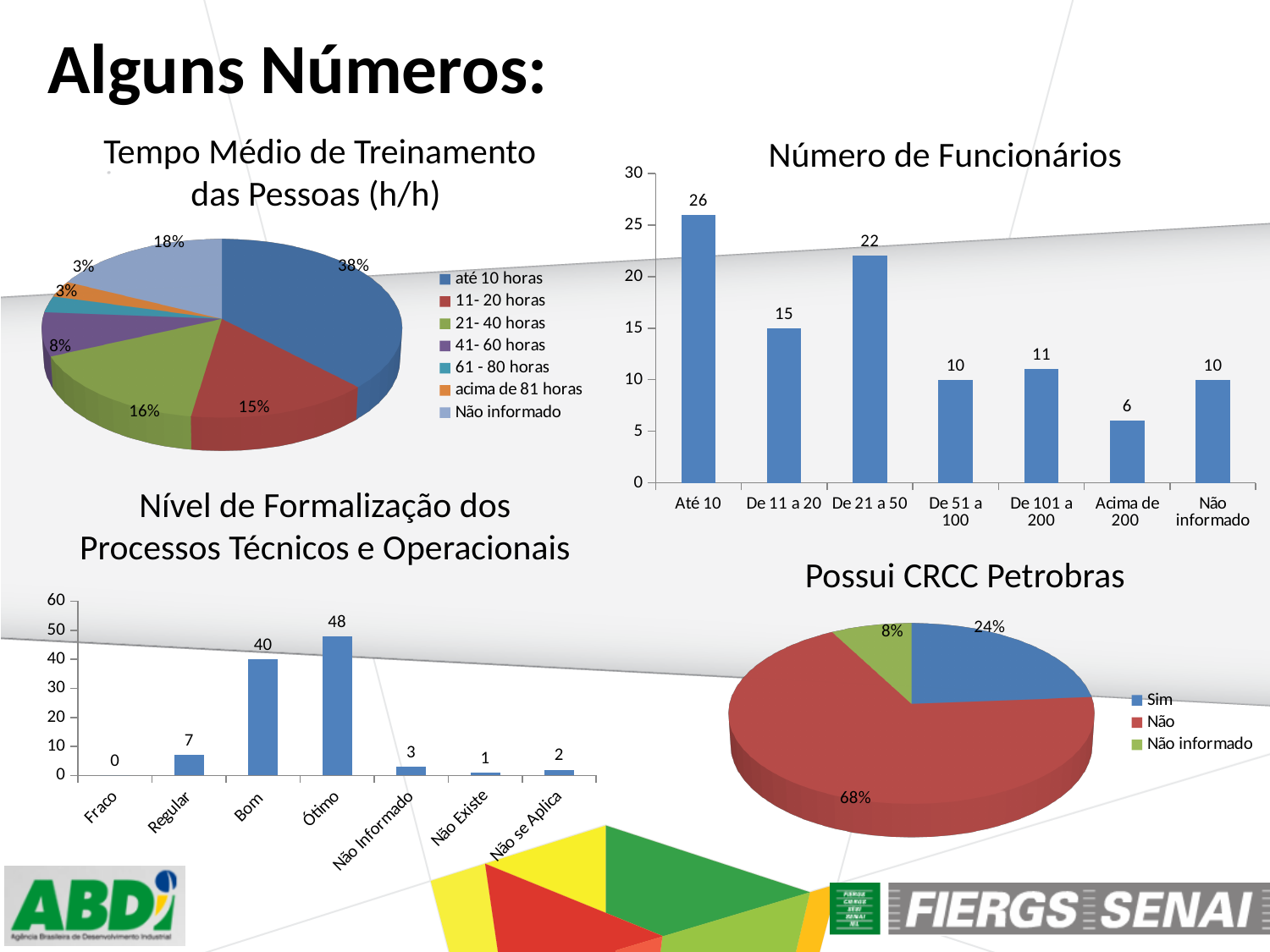
In the 'Número de Funcionários' chart, what is the difference between the values for 'Até 10' and 'De 11 a 20'? 11 In the 'Número de Funcionários' chart, what is the value for 'De 21 a 50'? 22 In the 'Possui CRCC Petrobras' chart, what share does 'Não' have? 68% In the 'Número de Funcionários' chart, which category has the lowest value? Acima de 200 In the 'Número de Funcionários' chart, which category has the highest value? Até 10 In the 'Tempo Médio de Treinamento das Pessoas (h/h)' chart, which is larger, '21- 40 horas' or '41- 60 horas'? 21- 40 horas In the 'Nível de Formalização dos Processos Técnicos e Operacionais' chart, how many categories are shown on the x axis? 7 In the 'Nível de Formalização dos Processos Técnicos e Operacionais' chart, which category has the highest value? Ótimo In the 'Nível de Formalização dos Processos Técnicos e Operacionais' chart, what is the value for 'Bom'? 40 In the 'Tempo Médio de Treinamento das Pessoas (h/h)' chart, what share does 'até 10 horas' have? 38% In the 'Possui CRCC Petrobras' chart, how many entries does the legend list? 3 What kind of chart is 'Tempo Médio de Treinamento das Pessoas (h/h)'? Pie chart